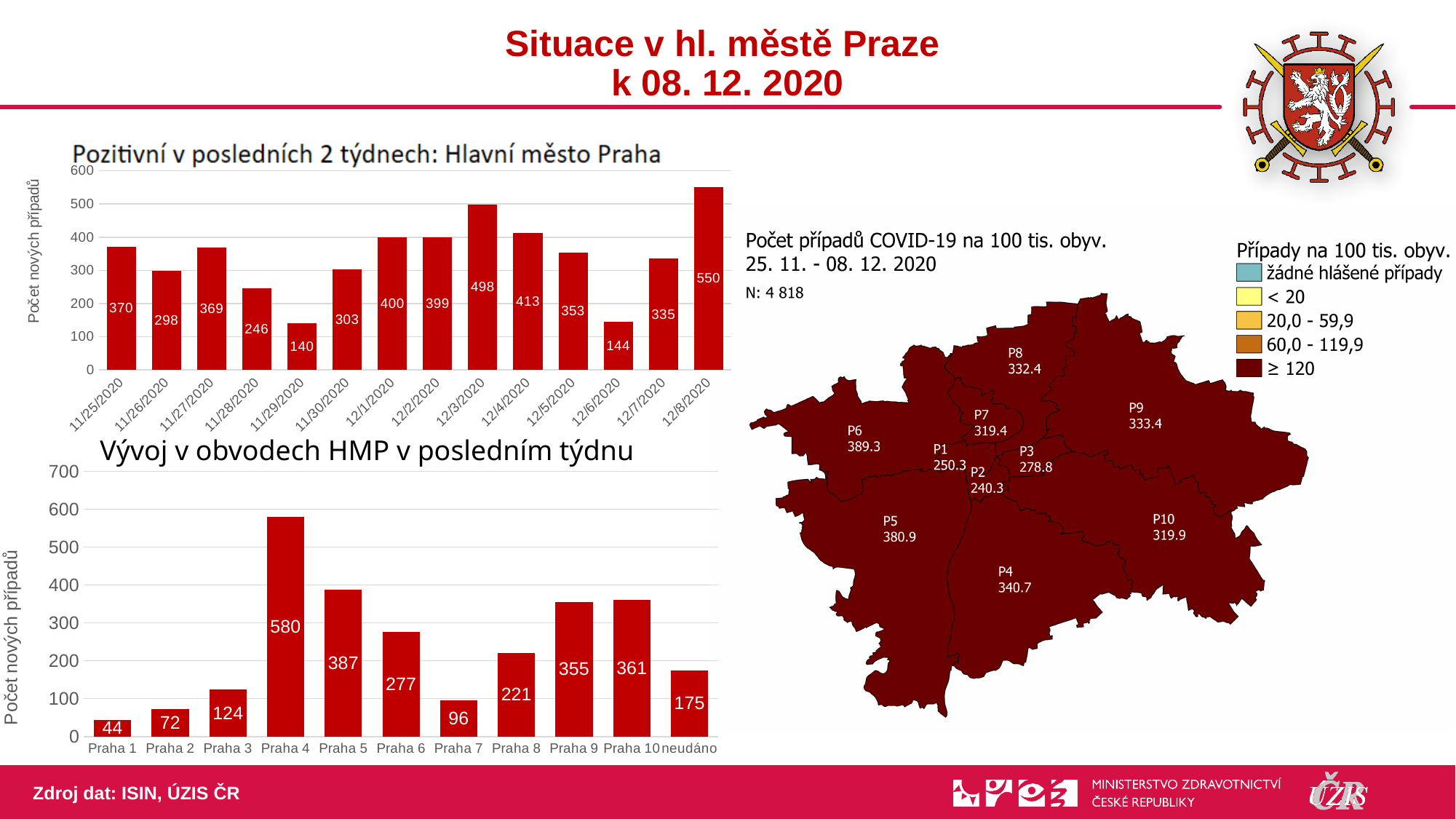
In the chart 'Vývoj v obvodech HMP v posledním týdnu', what is the value for Praha 5? 387 In the chart 'Pozitivní v posledních 2 týdnech: Hlavní město Praha', what is the value for 12/3/2020? 498 In the chart 'Pozitivní v posledních 2 týdnech: Hlavní město Praha', which date has the lowest value? 11/29/2020 In the chart 'Vývoj v obvodech HMP v posledním týdnu', what is the difference between the values for Praha 4 and Praha 5? 193 In the chart 'Vývoj v obvodech HMP v posledním týdnu', how many categories are shown on the x axis? 11 In the chart 'Vývoj v obvodech HMP v posledním týdnu', which category has the lowest value? Praha 1 In the chart 'Vývoj v obvodech HMP v posledním týdnu', which is larger, the value for Praha 9 or Praha 10? Praha 10 What kind of chart is 'Vývoj v obvodech HMP v posledním týdnu'? bar chart In the chart 'Pozitivní v posledních 2 týdnech: Hlavní město Praha', what is the difference between the values for 12/8/2020 and 12/7/2020? 215 In the chart 'Vývoj v obvodech HMP v posledním týdnu', which category has the highest value? Praha 4 In the chart 'Pozitivní v posledních 2 týdnech: Hlavní město Praha', how many dates are shown on the x axis? 14 In the chart 'Pozitivní v posledních 2 týdnech: Hlavní město Praha', which date has the highest value? 12/8/2020